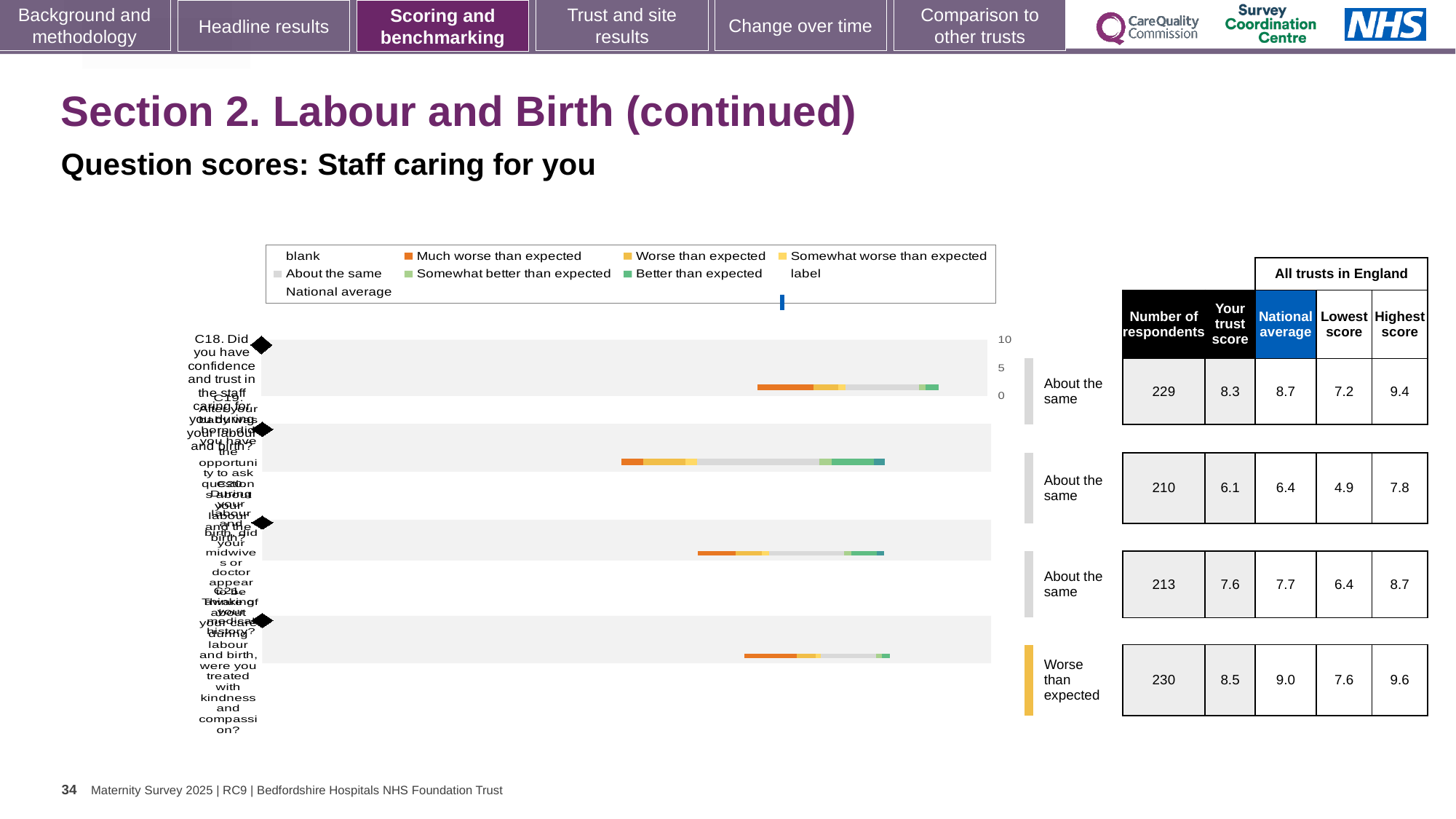
Which question has the lowest trust score? C19 What is the difference between the national average and the trust score for question C18? 0.4 What is the difference between the highest and lowest scores for question C21? 2.0 What is the trust score for question C18 (confidence and trust in the staff caring for you)? 8.3 For question C20, which is larger: the trust score or the national average? National average What kind of chart is shown on the slide? Bar chart What is the highest score among all trusts in England for question C19? 7.8 How many respondents answered question C21? 230 What is the national average for question C19? 6.4 How many questions (categories) are plotted in the chart? 4 What benchmark category is shown for question C21? Worse than expected Which question has the highest trust score? C21